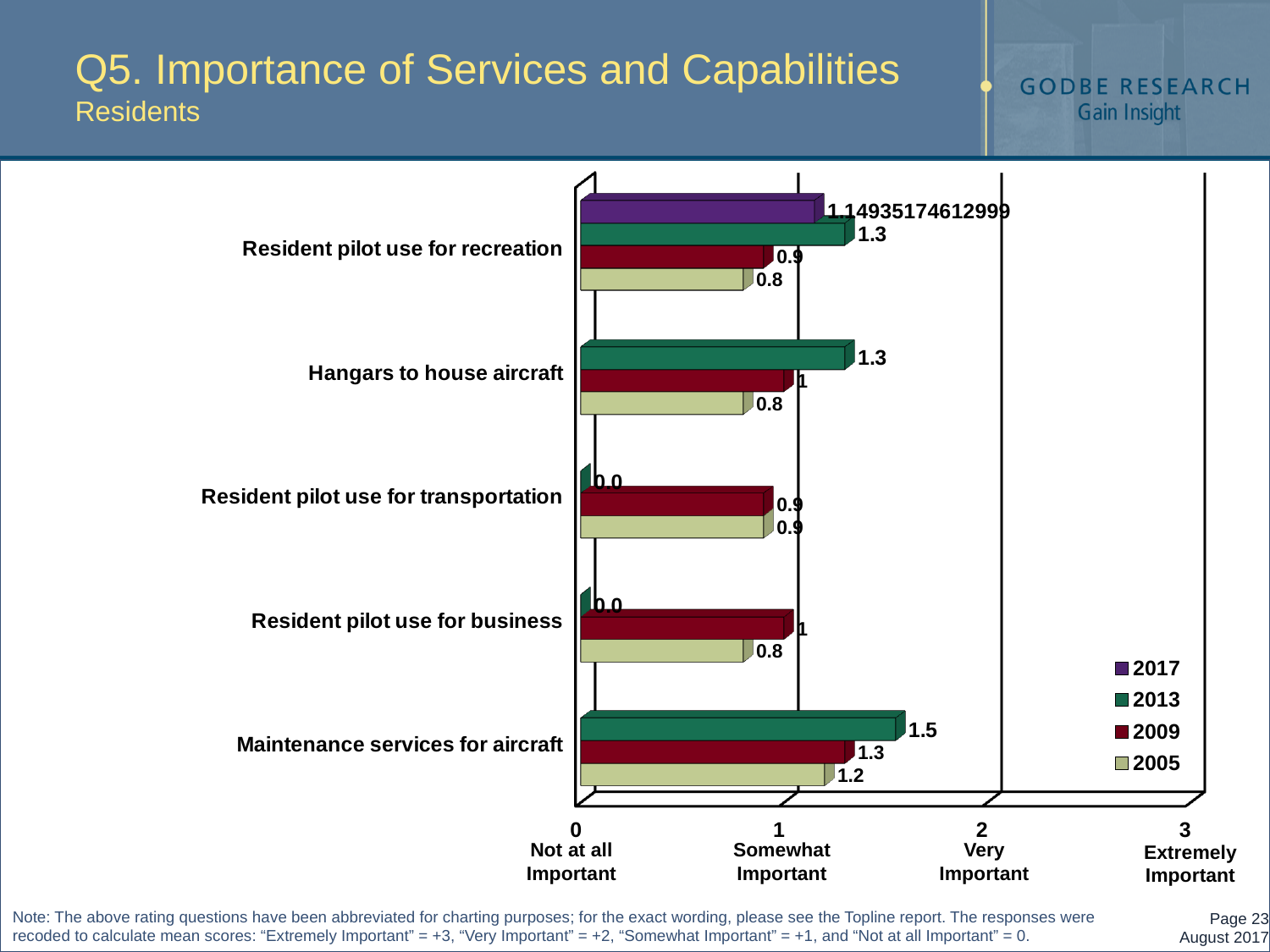
What is the 2005 value for Resident pilot use for recreation? 0.8 What is the 2005 value for Maintenance services for aircraft? 1.2 Is the 2013 value for Maintenance services for aircraft greater or less than 1? greater What label does the x axis give to the value 3? Extremely Important How many service categories are plotted on the chart? 5 What is the 2009 value for Hangars to house aircraft? 1 Which category has the highest 2013 value? Maintenance services for aircraft Which is larger: the 2009 value for Maintenance services for aircraft or the 2009 value for Resident pilot use for recreation? Maintenance services for aircraft How many series does the legend list? 4 What is the 2013 value for Maintenance services for aircraft? 1.5 What kind of chart is shown on the slide? bar chart What is the difference between the 2013 and 2005 values for Maintenance services for aircraft? 0.3